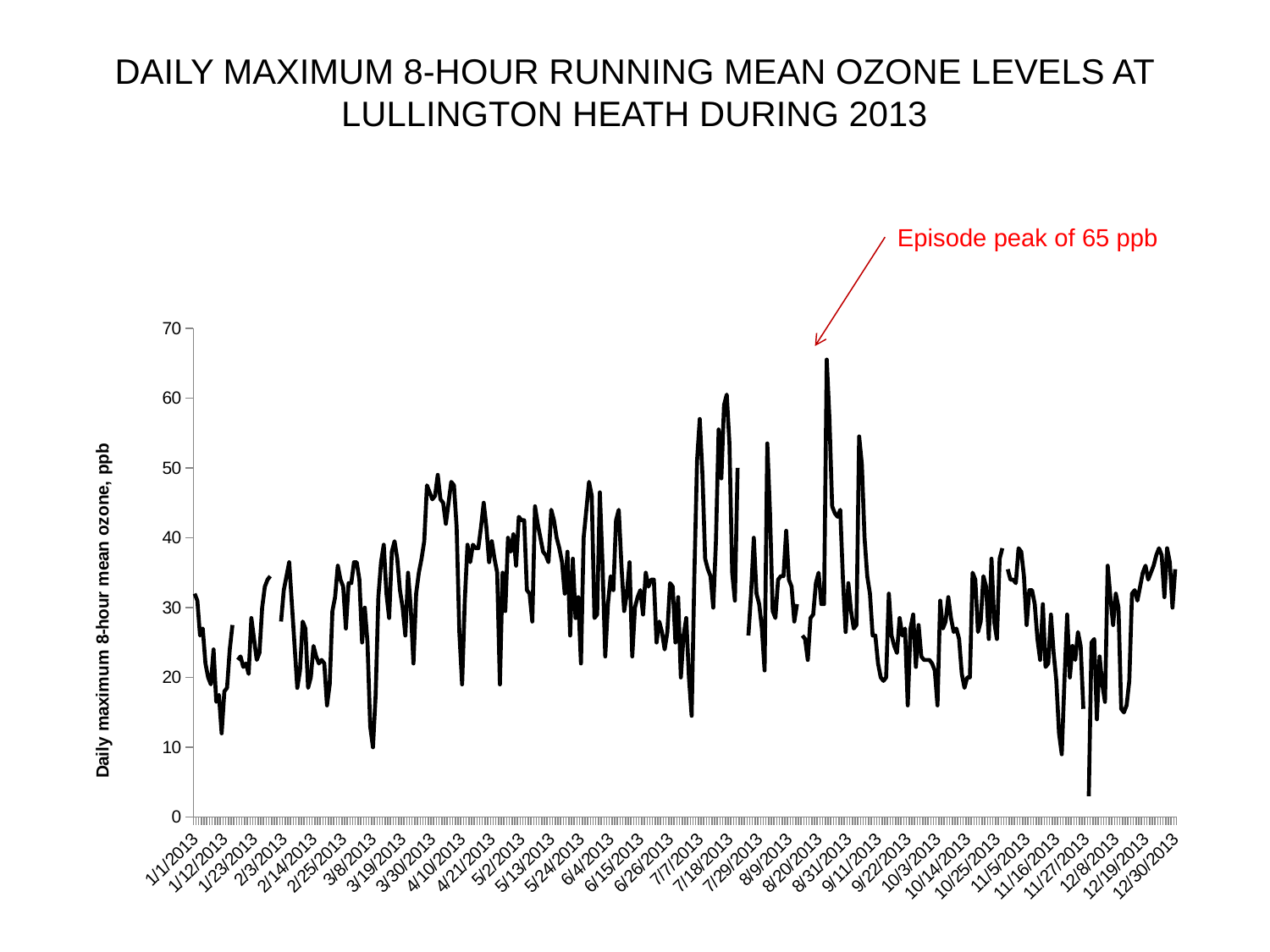
What kind of chart is shown on the slide? line chart How many data series are plotted on the chart? 1 Is the peak value in late July 2013 greater or less than 50? greater Is the episode peak value greater or less than 60? greater Is the value on 1/1/2013 greater or less than 20? greater What is the episode peak ozone level annotated on the chart? 65 ppb What is the highest tick value shown on the y axis? 70 What is the label of the y axis? Daily maximum 8-hour mean ozone, ppb In which month does the episode peak of 65 ppb occur? August 2013